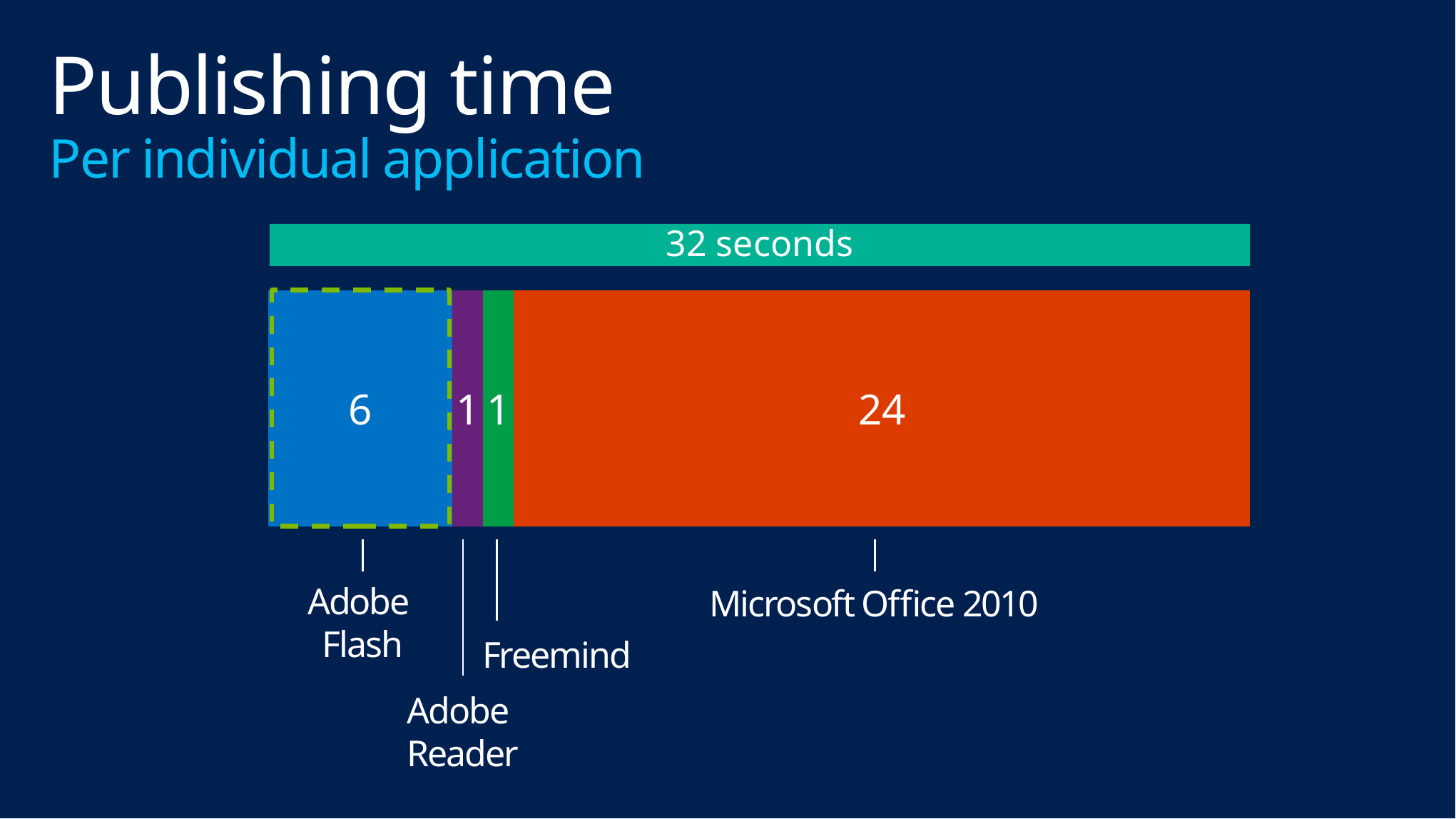
What is the publishing time for Adobe Flash? 6 What kind of chart is shown on the slide? Stacked bar chart What is the difference in publishing time between Microsoft Office 2010 and Adobe Flash? 18 What is the publishing time for Microsoft Office 2010? 24 Which application has the highest publishing time? Microsoft Office 2010 What is the total publishing time across all applications shown? 32 seconds Which has a larger publishing time, Adobe Flash or Freemind? Adobe Flash What is the publishing time for Freemind? 1 How many applications are shown in the chart? 4 What is the publishing time for Adobe Reader? 1 Which application's segment is outlined with a dashed border? Adobe Flash What is the title of the chart on the slide? Publishing time